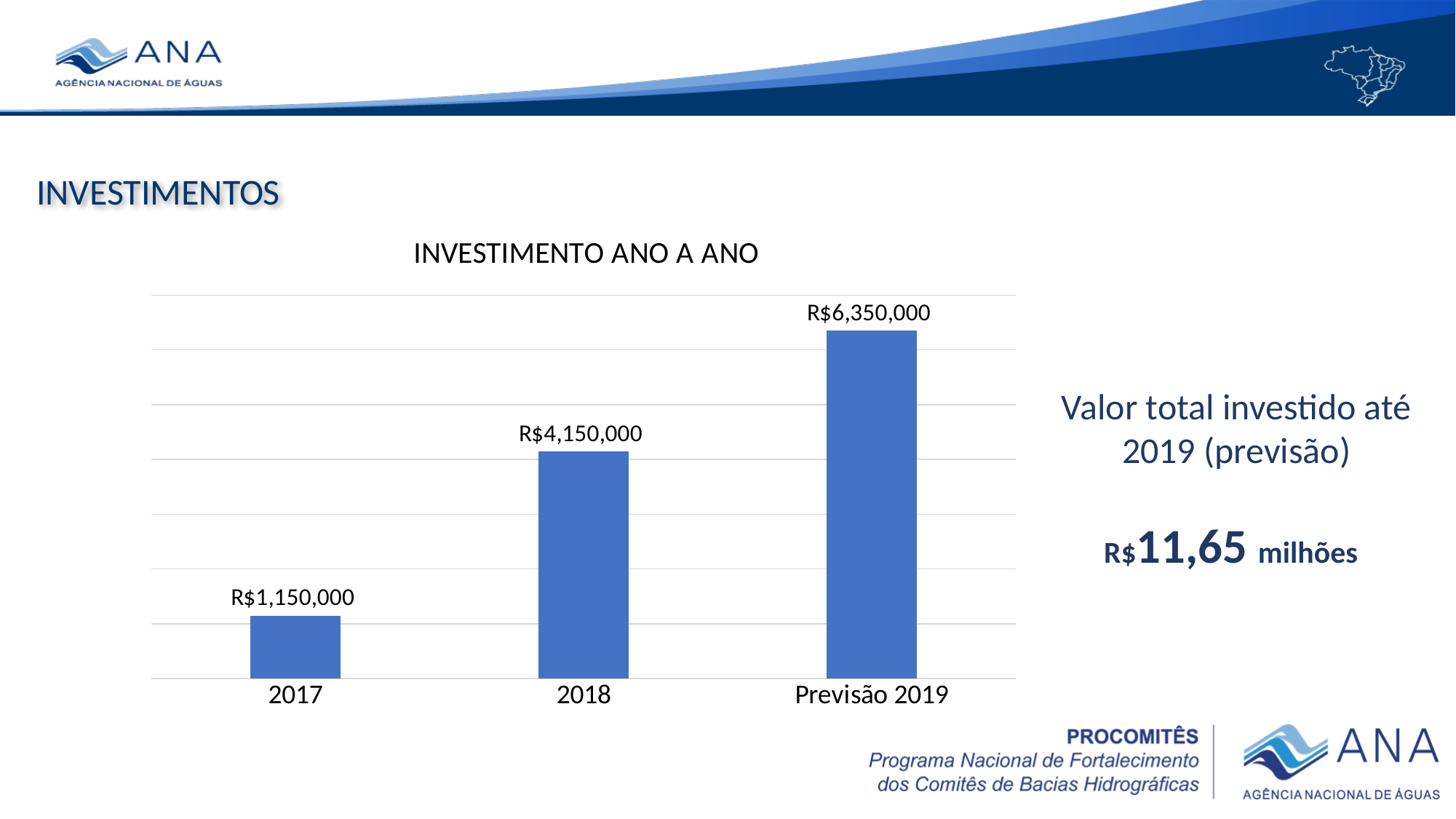
Which category has the highest value? Previsão 2019 What is the value for 2018? R$4,150,000 How many categories are shown on the x axis? 3 What is the difference between the values for 2018 and 2017? R$3,000,000 Which category has the lowest value? 2017 What is the value for Previsão 2019? R$6,350,000 Which is larger, the value for 2018 or the value for Previsão 2019? Previsão 2019 What is the difference between the values for Previsão 2019 and 2018? R$2,200,000 Do the values rise or fall from 2017 to Previsão 2019? rise What is the value for 2017? R$1,150,000 What kind of chart is shown? bar chart What is the title of the chart? INVESTIMENTO ANO A ANO